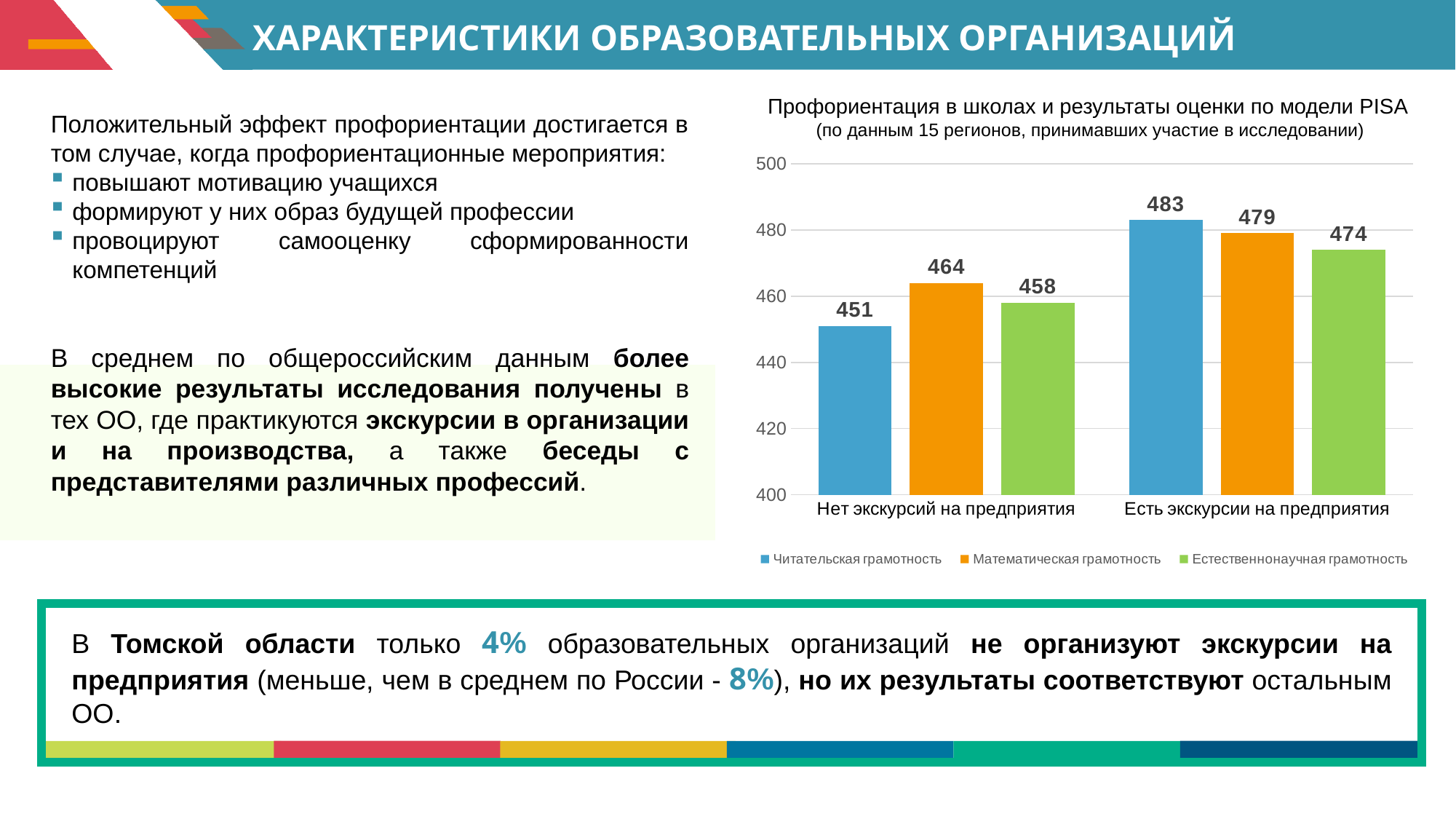
Which is larger: Математическая грамотность for Нет экскурсий на предприятия or Естественнонаучная грамотность for Есть экскурсии на предприятия? Естественнонаучная грамотность for Есть экскурсии на предприятия What kind of chart is shown on the slide? bar chart What is the difference between the Читательская грамотность values for Есть экскурсии на предприятия and Нет экскурсий на предприятия? 32 Which series has the lowest value in the category Нет экскурсий на предприятия? Читательская грамотность How many series does the legend list? 3 How many categories are shown on the x axis of the chart? 2 Is the value for Естественнонаучная грамотность in the category Есть экскурсии на предприятия greater or less than 460? greater What is the value for Читательская грамотность in the category Нет экскурсий на предприятия? 451 What is the value for Математическая грамотность in the category Есть экскурсии на предприятия? 479 What colour are the bars for Математическая грамотность? orange What is the value for Естественнонаучная грамотность in the category Нет экскурсий на предприятия? 458 Which series has the highest value in the category Есть экскурсии на предприятия? Читательская грамотность